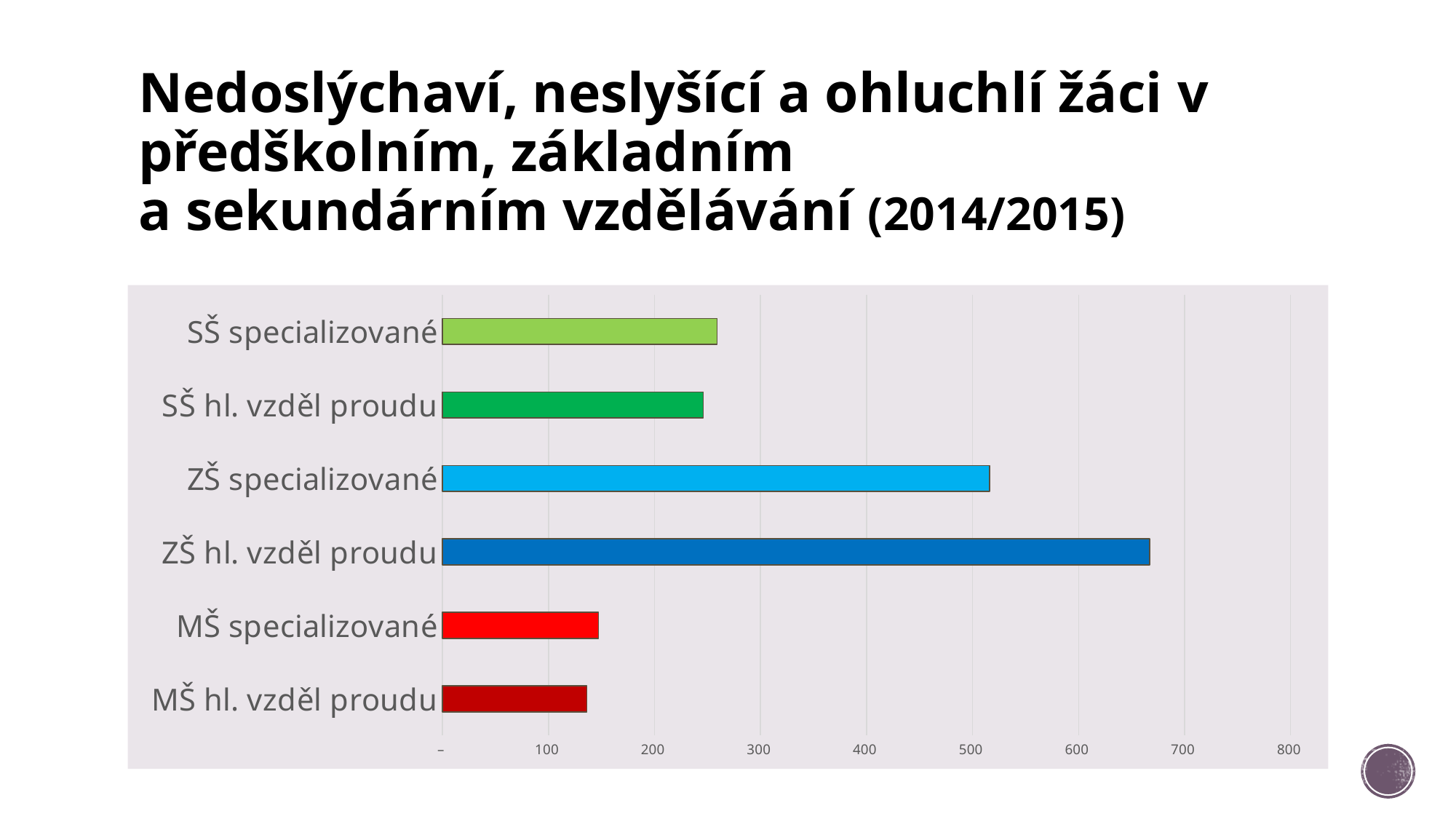
Is the value for SŠ hl. vzděl proudu greater or less than 200? greater What school year is given in the slide title? 2014/2015 Which category has the highest value? ZŠ hl. vzděl proudu What kind of chart is shown on the slide? bar chart Is the value for ZŠ hl. vzděl proudu greater or less than 600? greater Which is larger, the value for ZŠ hl. vzděl proudu or ZŠ specializované? ZŠ hl. vzděl proudu Which category has the lowest value? MŠ hl. vzděl proudu Is the value for MŠ hl. vzděl proudu greater or less than 200? less How many categories are plotted in the chart? 6 Which is larger, the value for SŠ specializované or MŠ specializované? SŠ specializované